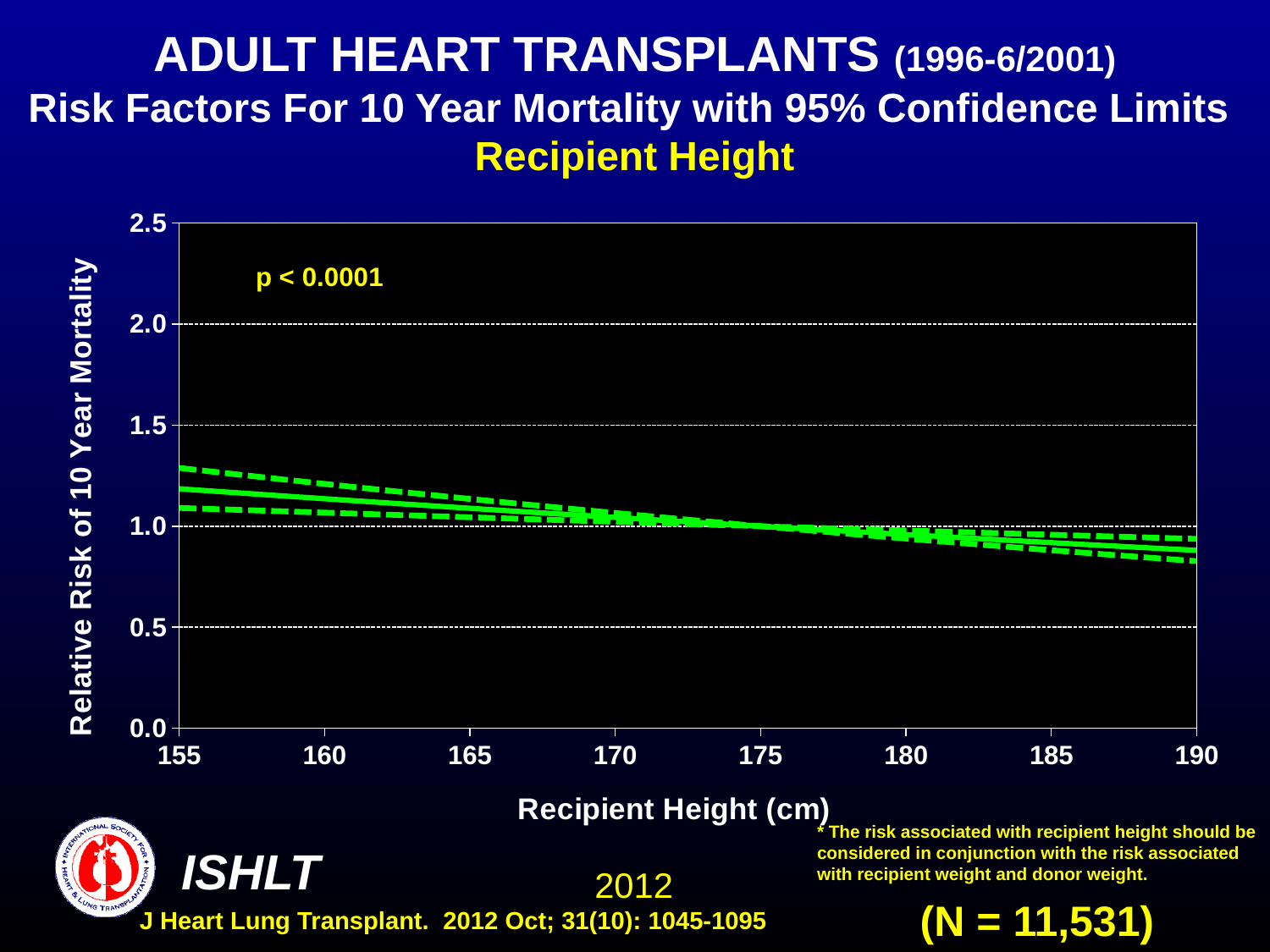
What kind of chart is shown on the slide? line chart How many lines are plotted on the chart (the estimate plus its confidence limits)? 3 Which recipient height has the higher relative risk of 10 year mortality, 155 cm or 190 cm? 155 cm Is the relative risk of 10 year mortality at a recipient height of 190 cm greater or less than 1.0? less What is the p-value shown on the chart? p < 0.0001 Is the upper 95% confidence limit at a recipient height of 155 cm greater or less than 1.0? greater Is the relative risk of 10 year mortality at a recipient height of 155 cm greater or less than 1.5? less Does the relative risk of 10 year mortality rise or fall as recipient height increases from 155 cm to 190 cm? fall What is the label of the x axis? Recipient Height (cm)